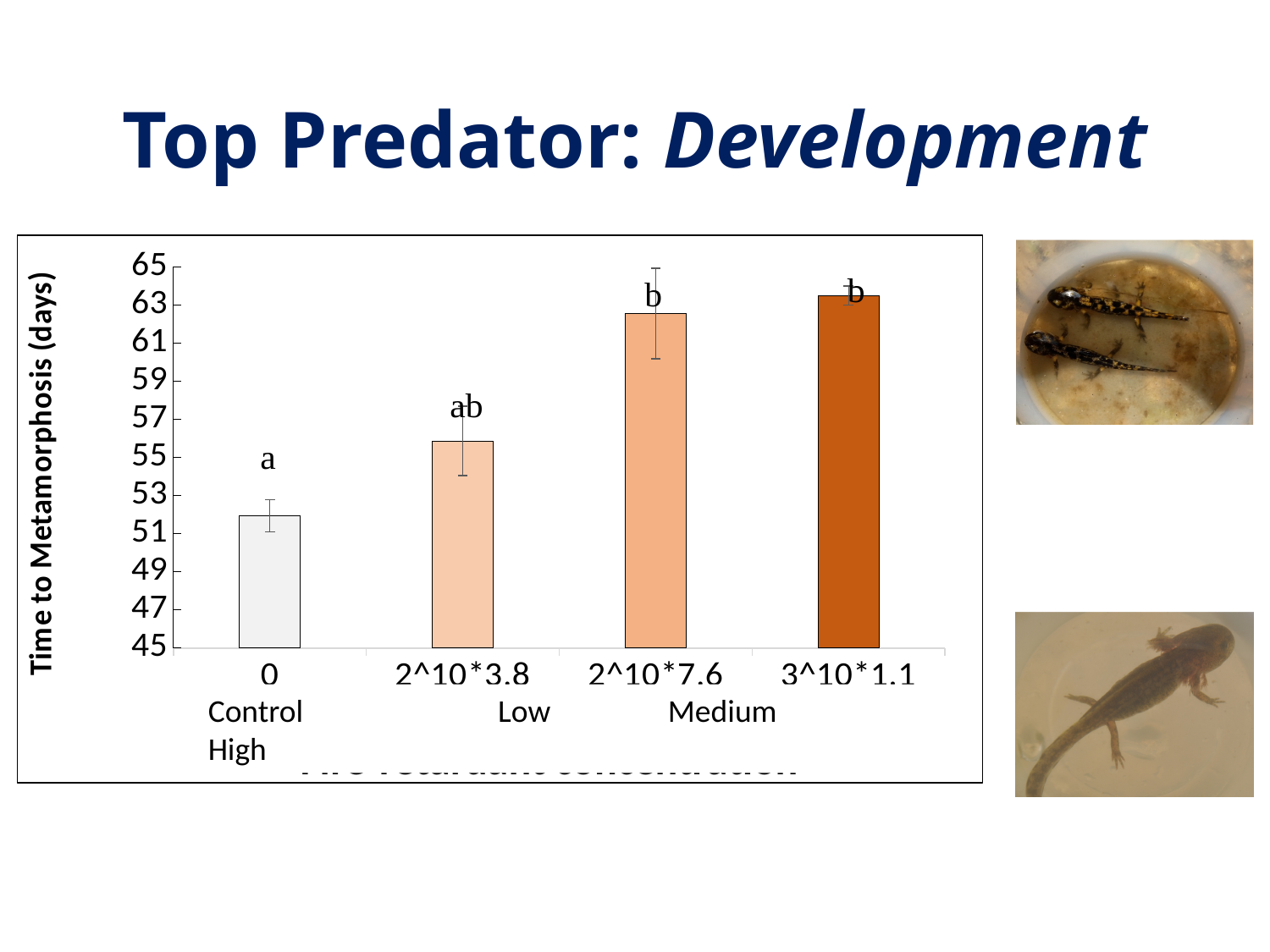
Which has a larger time to metamorphosis, 2^10*3.8 or 2^10*7.6? 2^10*7.6 What is the label of the y axis? Time to Metamorphosis (days) Do the bar values rise or fall from left to right along the x axis? rise What kind of chart is shown on the slide? bar chart Is the value for the 3^10*1.1 bar greater or less than 61? greater Which category has the lowest time to metamorphosis? 0 What letter is printed above the 2^10*3.8 bar? ab Is the value for the 2^10*3.8 bar greater or less than 55? greater Is the value for the 2^10*7.6 bar greater or less than 61? greater How many bars (fire retardant concentration categories) are plotted in the chart? 4 Which has a larger time to metamorphosis, 0 or 3^10*1.1? 3^10*1.1